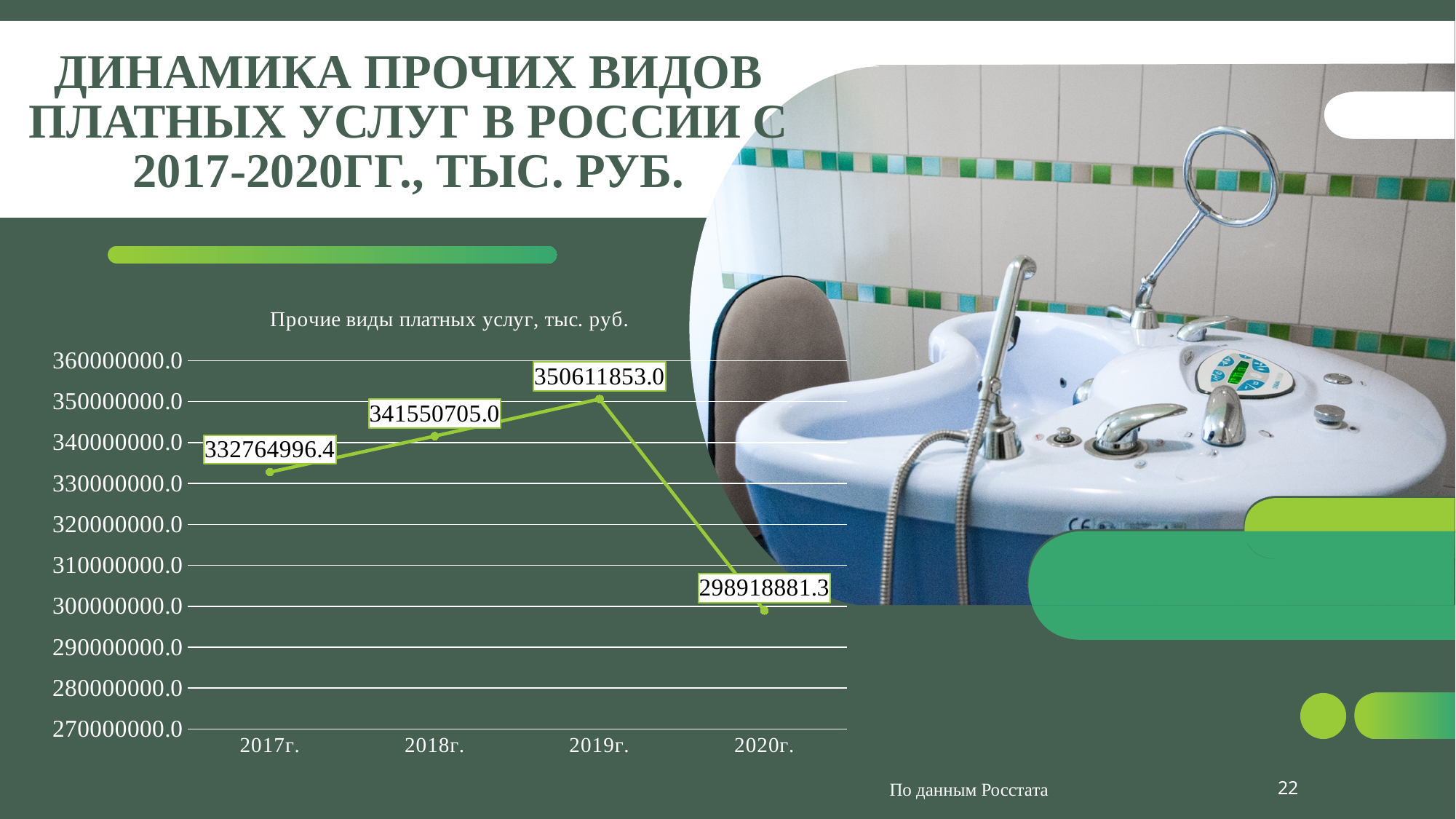
What is the value for 2018г.? 341550705.0 What is the value for 2020г.? 298918881.3 What is the value for 2019г.? 350611853.0 What is the value for 2017г.? 332764996.4 How many years are plotted on the chart? 4 What kind of chart is shown on the slide? line chart Which year has the lowest value? 2020г. What is the difference between the values for 2019г. and 2020г.? 51692971.7 What is the difference between the values for 2019г. and 2018г.? 9061148.0 What is the title of the chart? Прочие виды платных услуг, тыс. руб. Which is larger, the value for 2018г. or the value for 2020г.? 2018г. Which year has the highest value? 2019г.